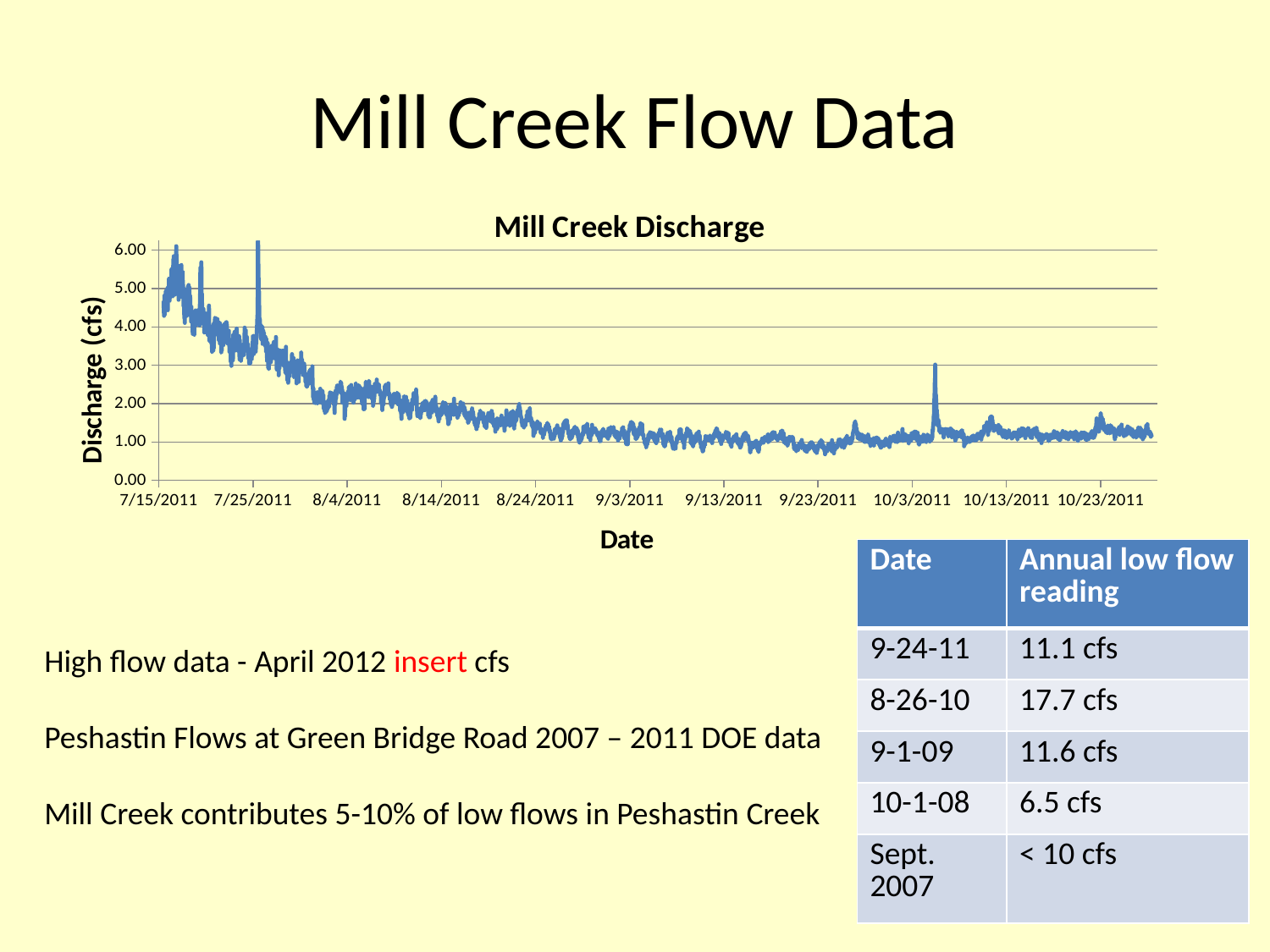
On the Mill Creek Discharge chart, which date has the lower discharge, 7/15/2011 or 10/13/2011? 10/13/2011 On the Mill Creek Discharge chart, is the discharge at 10/23/2011 greater or less than 2.00? less What kind of chart is the Mill Creek Discharge chart? line chart What is the highest value shown on the y axis of the Mill Creek Discharge chart? 6.00 On the Mill Creek Discharge chart, is the discharge at 7/15/2011 greater or less than 4.00? greater On the Mill Creek Discharge chart, is the discharge at 9/13/2011 greater or less than 2.00? less What is the label of the y axis on the Mill Creek Discharge chart? Discharge (cfs) On the Mill Creek Discharge chart, which date has the higher discharge, 7/25/2011 or 9/23/2011? 7/25/2011 Overall, do the discharge values rise or fall from 7/15/2011 to 10/23/2011 on the Mill Creek Discharge chart? fall What is the title of the chart? Mill Creek Discharge